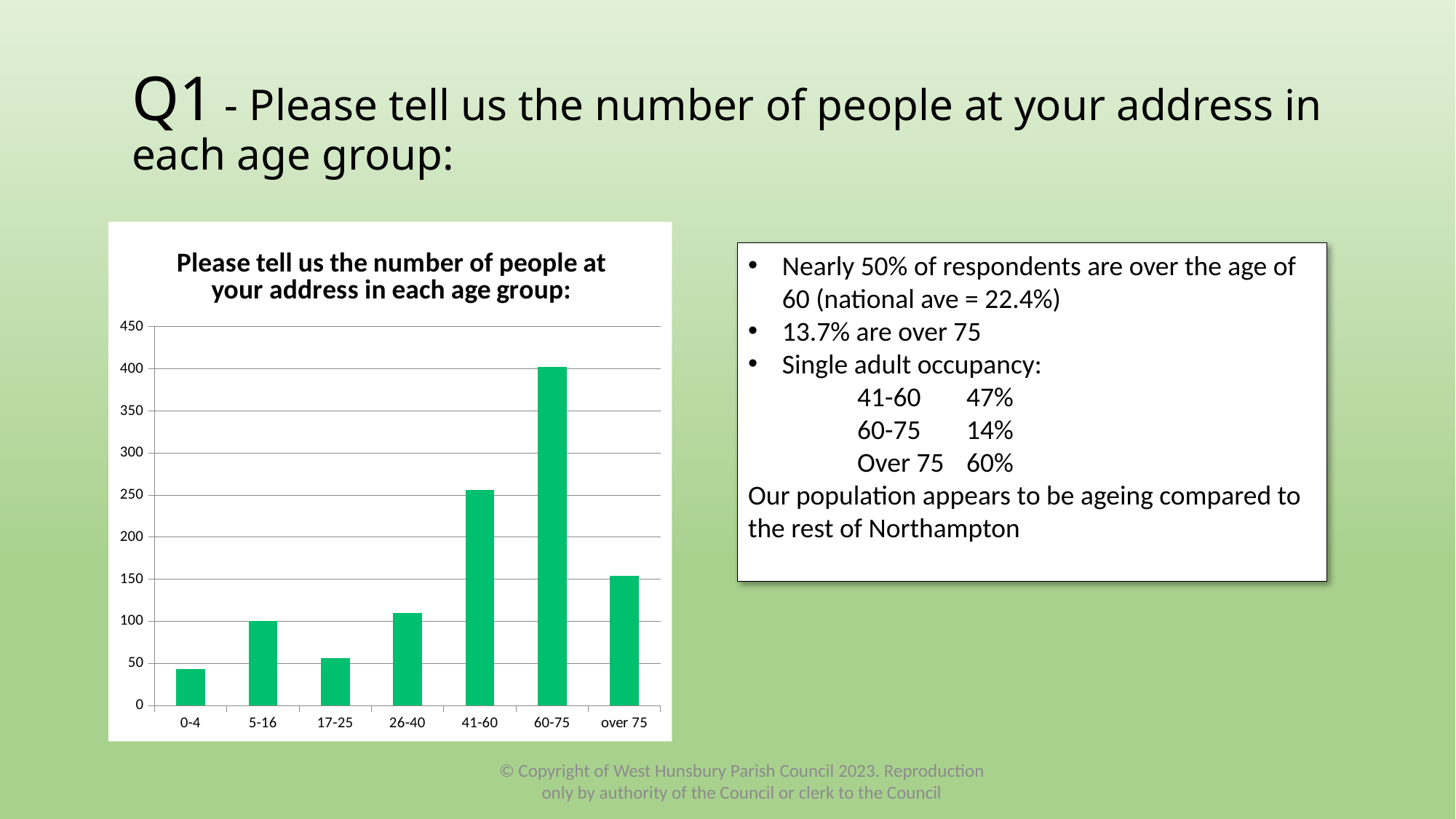
What is the title of the chart? Please tell us the number of people at your address in each age group: How many age group categories are shown on the x axis of the chart? 7 What kind of chart is shown on the slide? bar chart Which age group has a larger value, 26-40 or 17-25? 26-40 Is the value for the 41-60 age group greater or less than 250? greater Which age group has the highest bar in the chart? 60-75 Is the value for the 17-25 age group greater or less than 100? less Is the value for the 0-4 age group greater or less than 50? less Which age group has the lowest bar in the chart? 0-4 Which age group has a larger value, 41-60 or over 75? 41-60